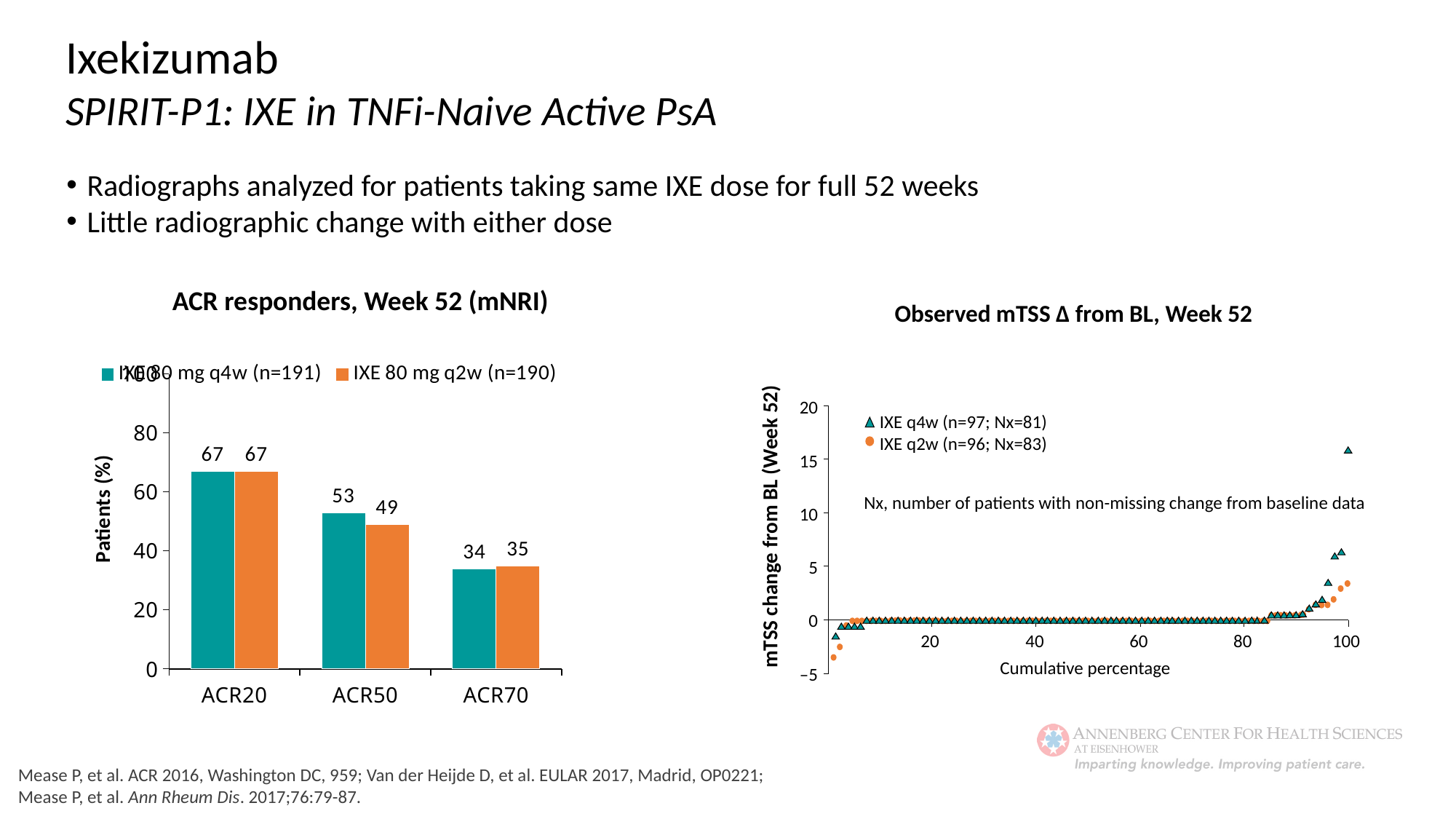
In the ACR responders, Week 52 (mNRI) chart, what is the ACR70 value for IXE 80 mg q4w (n=191)? 34 In the Observed mTSS Δ from BL, Week 52 chart, how many series does the legend list? 2 What kind of chart is the ACR responders, Week 52 (mNRI) chart? Bar chart In the Observed mTSS Δ from BL, Week 52 chart, is the highest IXE q4w point greater or less than 10? greater In the ACR responders, Week 52 (mNRI) chart, how many categories are shown on the x axis? 3 In the ACR responders, Week 52 (mNRI) chart, what is the ACR50 value for IXE 80 mg q2w (n=190)? 49 In the ACR responders, Week 52 (mNRI) chart, do the values for IXE 80 mg q4w rise or fall from ACR20 to ACR70? Fall In the ACR responders, Week 52 (mNRI) chart, how many series does the legend list? 2 In the ACR responders, Week 52 (mNRI) chart, what is the difference between the ACR50 values for IXE 80 mg q4w and IXE 80 mg q2w? 4 In the ACR responders, Week 52 (mNRI) chart, which is larger for ACR70: IXE 80 mg q4w or IXE 80 mg q2w? IXE 80 mg q2w In the ACR responders, Week 52 (mNRI) chart, which category has the lowest value for IXE 80 mg q2w (n=190)? ACR70 In the ACR responders, Week 52 (mNRI) chart, what is the ACR20 value for IXE 80 mg q4w (n=191)? 67